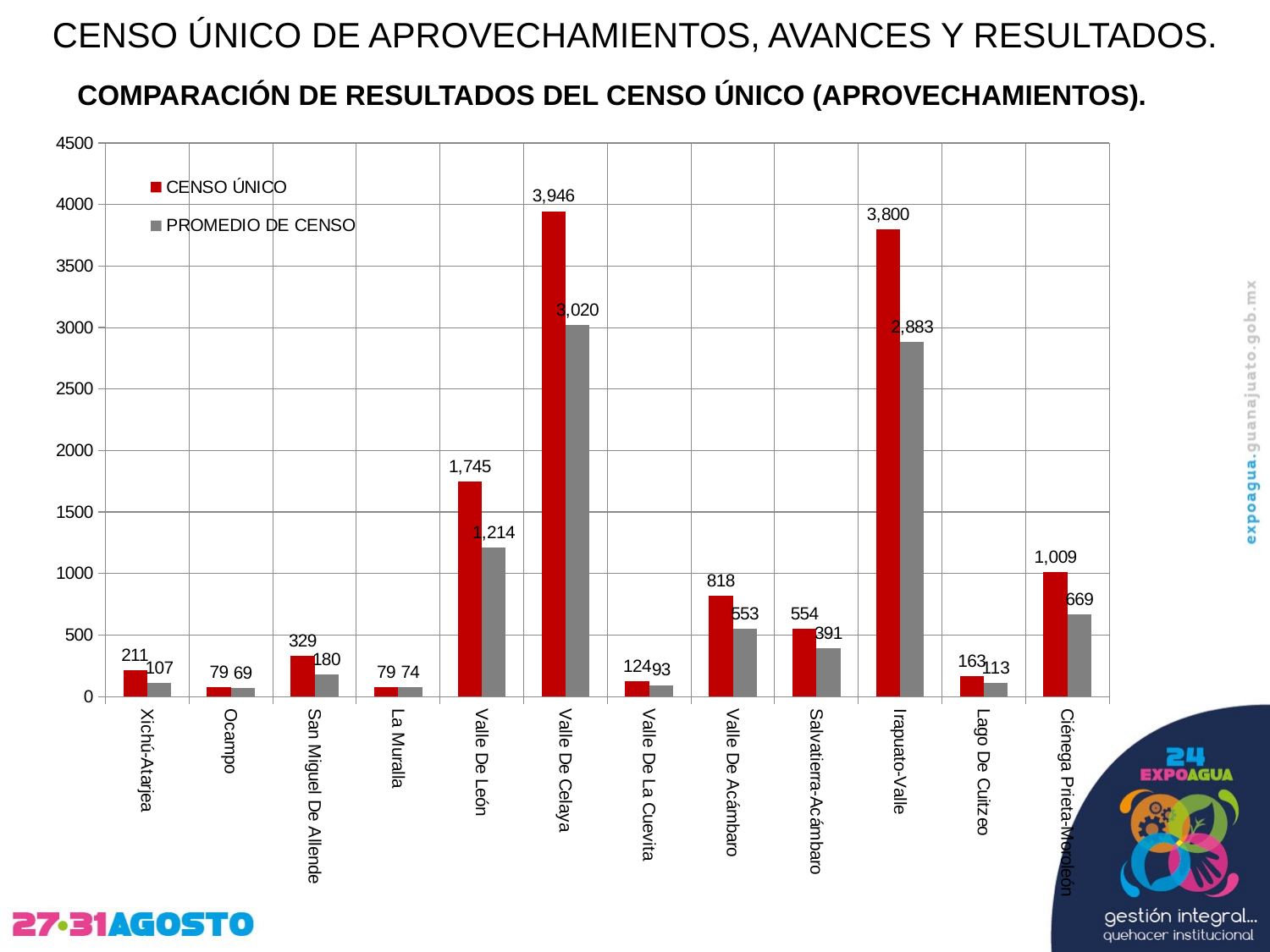
Which category has the highest CENSO ÚNICO value? Valle De Celaya How many series does the legend list? 2 What is the CENSO ÚNICO value for Valle De Acámbaro? 818 Which is larger for Salvatierra-Acámbaro: the CENSO ÚNICO value or the PROMEDIO DE CENSO value? CENSO ÚNICO What is the PROMEDIO DE CENSO value for Irapuato-Valle? 2,883 Which category has the lowest PROMEDIO DE CENSO value? Ocampo How many categories are shown on the x axis? 12 Which series is shown in red? CENSO ÚNICO Is the CENSO ÚNICO value for Irapuato-Valle greater or less than 3500? greater What is the CENSO ÚNICO value for Valle De Celaya? 3,946 What is the difference between the CENSO ÚNICO and PROMEDIO DE CENSO values for Valle De León? 531 What kind of chart is shown on the slide? Bar chart